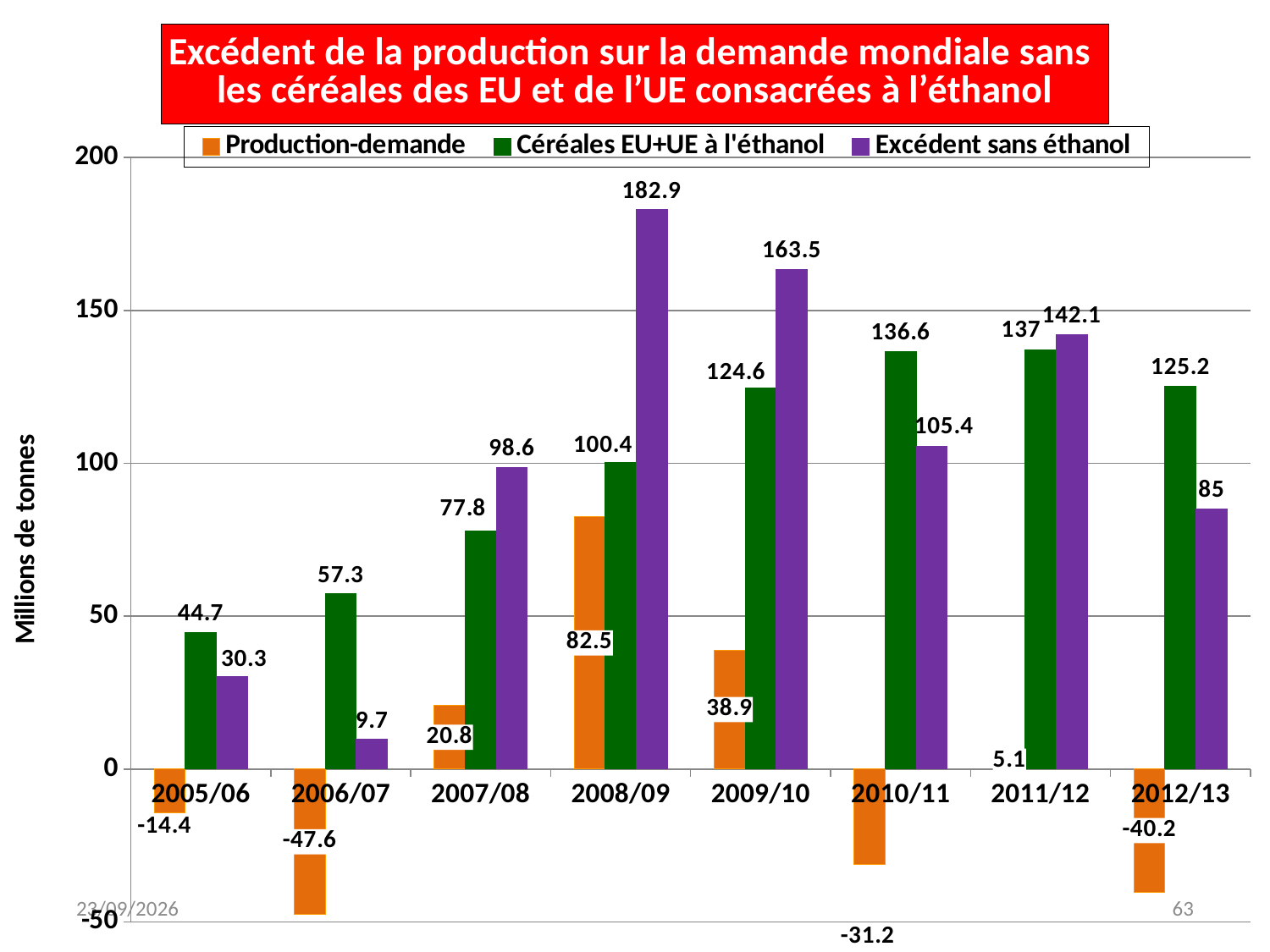
What is the value of Excédent sans éthanol for 2008/09? 182.9 What is the difference between Excédent sans éthanol and Céréales EU+UE à l'éthanol in 2011/12? 5.1 How many series does the legend list? 3 What is the label of the y axis? Millions de tonnes What is the value of Production-demande for 2006/07? -47.6 Does Céréales EU+UE à l'éthanol rise or fall from 2005/06 to 2011/12? Rise What is the value of Céréales EU+UE à l'éthanol for 2012/13? 125.2 In which year is Excédent sans éthanol the highest? 2008/09 What kind of chart is shown on the slide? Bar chart In 2010/11, which is larger: Céréales EU+UE à l'éthanol or Excédent sans éthanol? Céréales EU+UE à l'éthanol In which year is Production-demande the lowest? 2006/07 How many years are shown on the x axis? 8